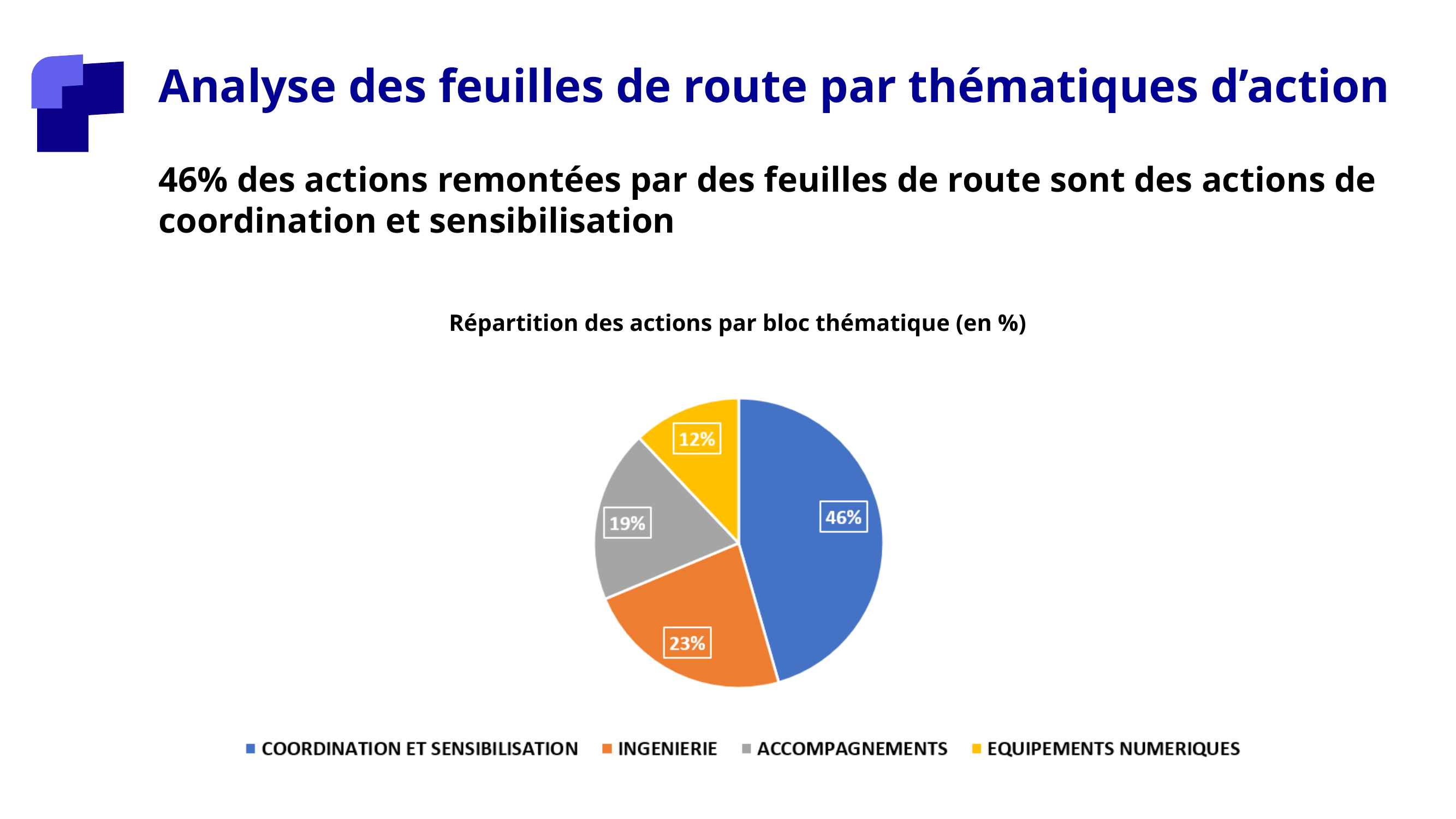
What share of actions is EQUIPEMENTS NUMERIQUES? 12% What share of actions is ACCOMPAGNEMENTS? 19% What colour is the slice for INGENIERIE? orange Which is larger, the share for ACCOMPAGNEMENTS or the share for EQUIPEMENTS NUMERIQUES? ACCOMPAGNEMENTS What kind of chart is shown on the slide? pie chart Which category has the smallest share of the pie? EQUIPEMENTS NUMERIQUES Which category has the largest share of the pie? COORDINATION ET SENSIBILISATION What is the difference in percentage points between COORDINATION ET SENSIBILISATION and INGENIERIE? 23 What share of actions is COORDINATION ET SENSIBILISATION? 46% How many categories does the pie chart have? 4 What share of actions is INGENIERIE? 23% What is the title of the chart? Répartition des actions par bloc thématique (en %)